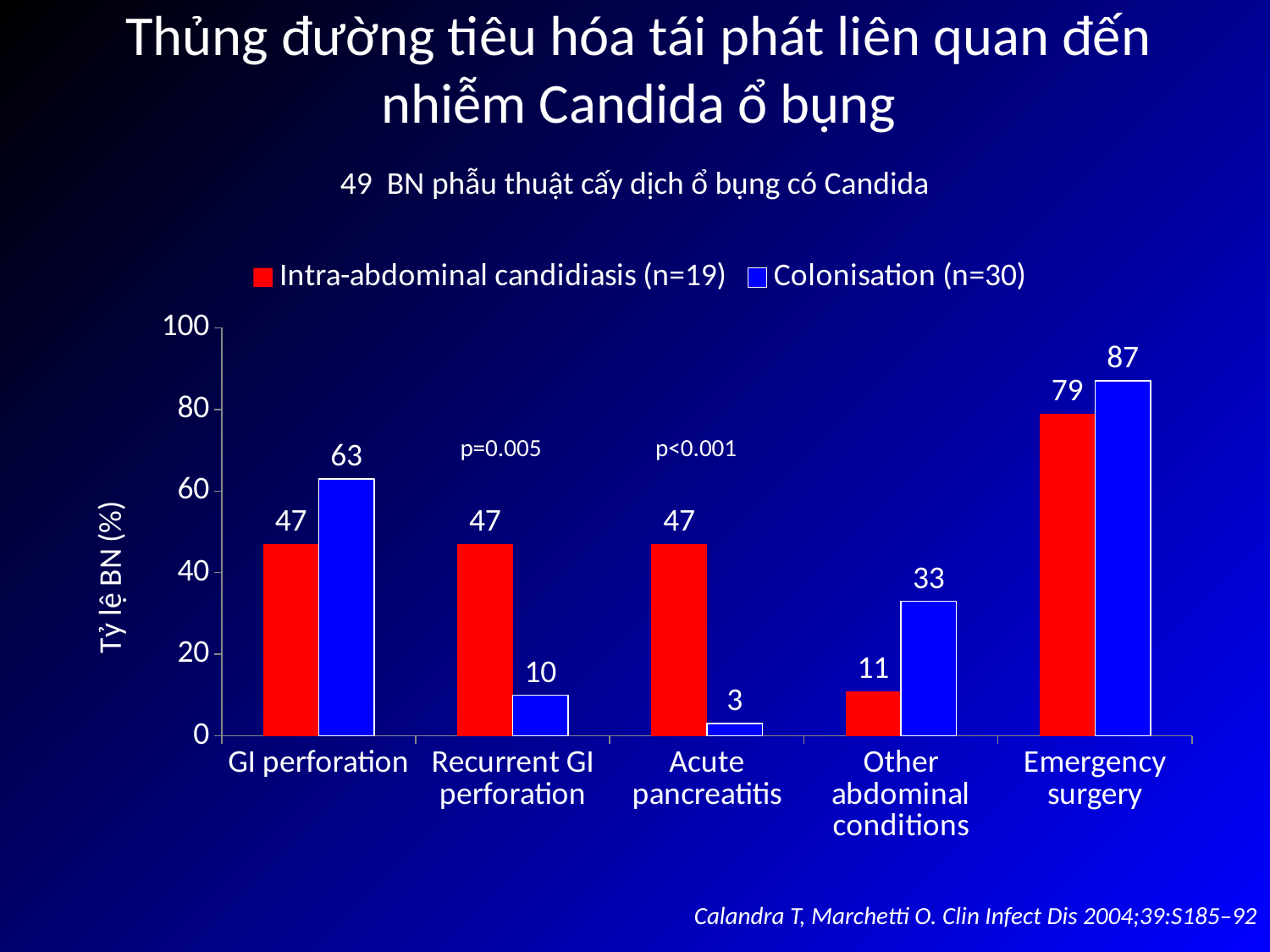
Which category has the highest value for Colonisation (n=30)? Emergency surgery What kind of chart is shown on the slide? Bar chart Which category has the lowest value for Intra-abdominal candidiasis (n=19)? Other abdominal conditions How many series does the legend list? 2 In the Recurrent GI perforation category, which series has the larger value? Intra-abdominal candidiasis (n=19) What is the value for Intra-abdominal candidiasis (n=19) in the Recurrent GI perforation category? 47 How many categories are shown on the x axis? 5 What is the difference between the Colonisation (n=30) and Intra-abdominal candidiasis (n=19) values for GI perforation? 16 What is the value for Colonisation (n=30) in the Acute pancreatitis category? 3 What p-value is shown above the Acute pancreatitis bars? p<0.001 What is the label of the y axis? Tỷ lệ BN (%) What is the value for Colonisation (n=30) in the Emergency surgery category? 87